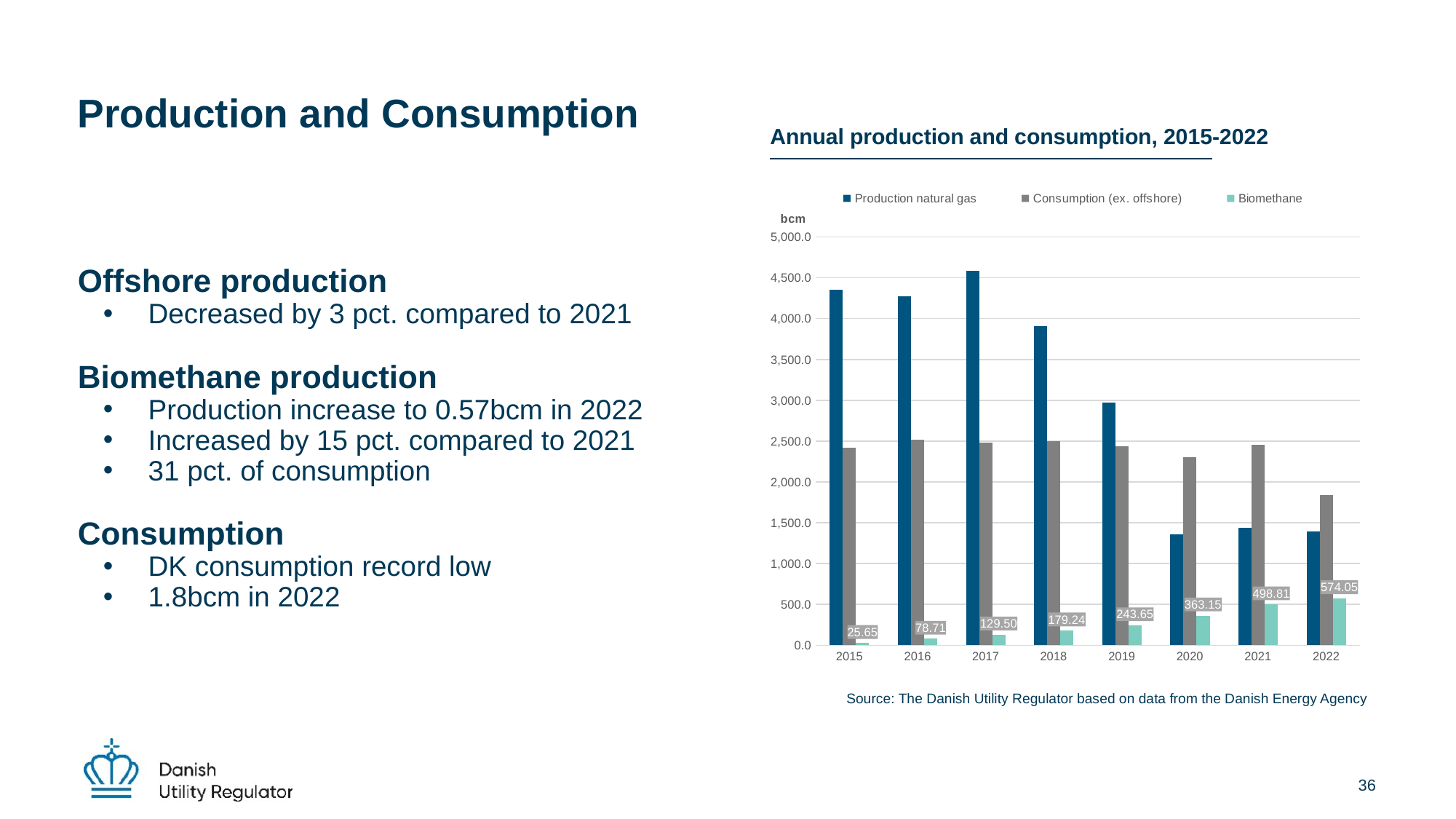
Is the Consumption (ex. offshore) value for 2022 greater or less than 2,000.0? less How many series does the chart's legend list? 3 In which year is the Biomethane value lowest? 2015 What is the Biomethane value for 2022? 574.05 Which year has the higher Production natural gas value, 2017 or 2018? 2017 Is the Production natural gas value for 2020 greater or less than 1,500.0? less What is the Biomethane value for 2019? 243.65 In which year is the Biomethane value highest? 2022 How many years are shown on the x axis of the chart? 8 What is the difference between the Biomethane values for 2022 and 2021? 75.24 What is the Biomethane value for 2015? 25.65 What kind of chart is shown on the slide? bar chart